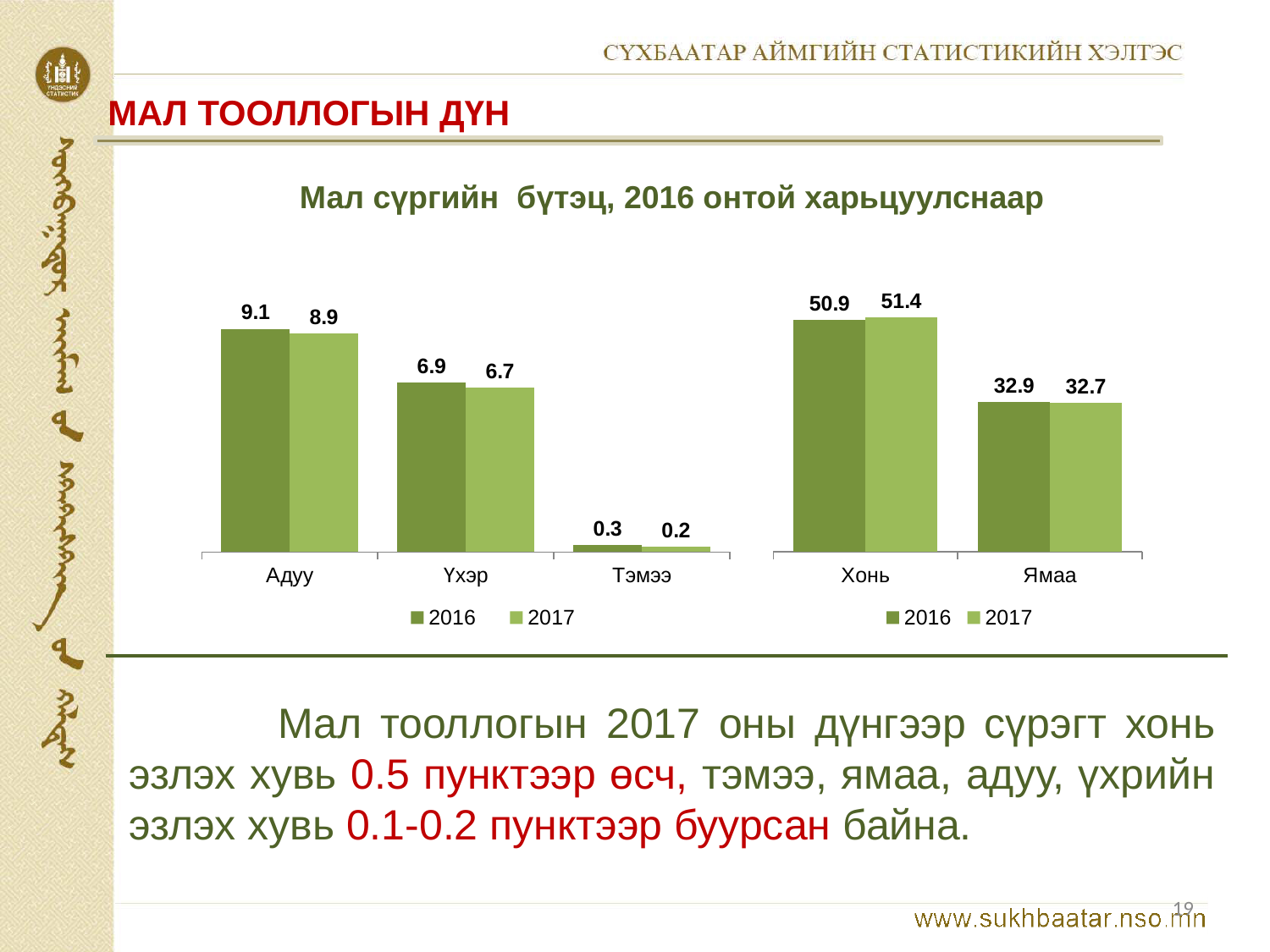
In the right chart, what is the difference between the 2017 and 2016 values for Хонь? 0.5 What type of chart is the right chart? bar chart How many categories are shown in the left chart? 3 In the left chart, which category has the lowest 2017 value? Тэмээ In the left chart, what is the 2017 value for Үхэр? 6.7 In the right chart, what is the 2016 value for Ямаа? 32.9 In the left chart, is the 2016 value for Үхэр larger or smaller than the 2017 value for Үхэр? larger In the right chart, what is the 2017 value for Хонь? 51.4 How many series does the legend of the right chart list? 2 In the right chart, which category has the highest 2016 value? Хонь In the left chart, what is the 2016 value for Адуу? 9.1 In the left chart, what is the difference between the 2016 and 2017 values for Адуу? 0.2